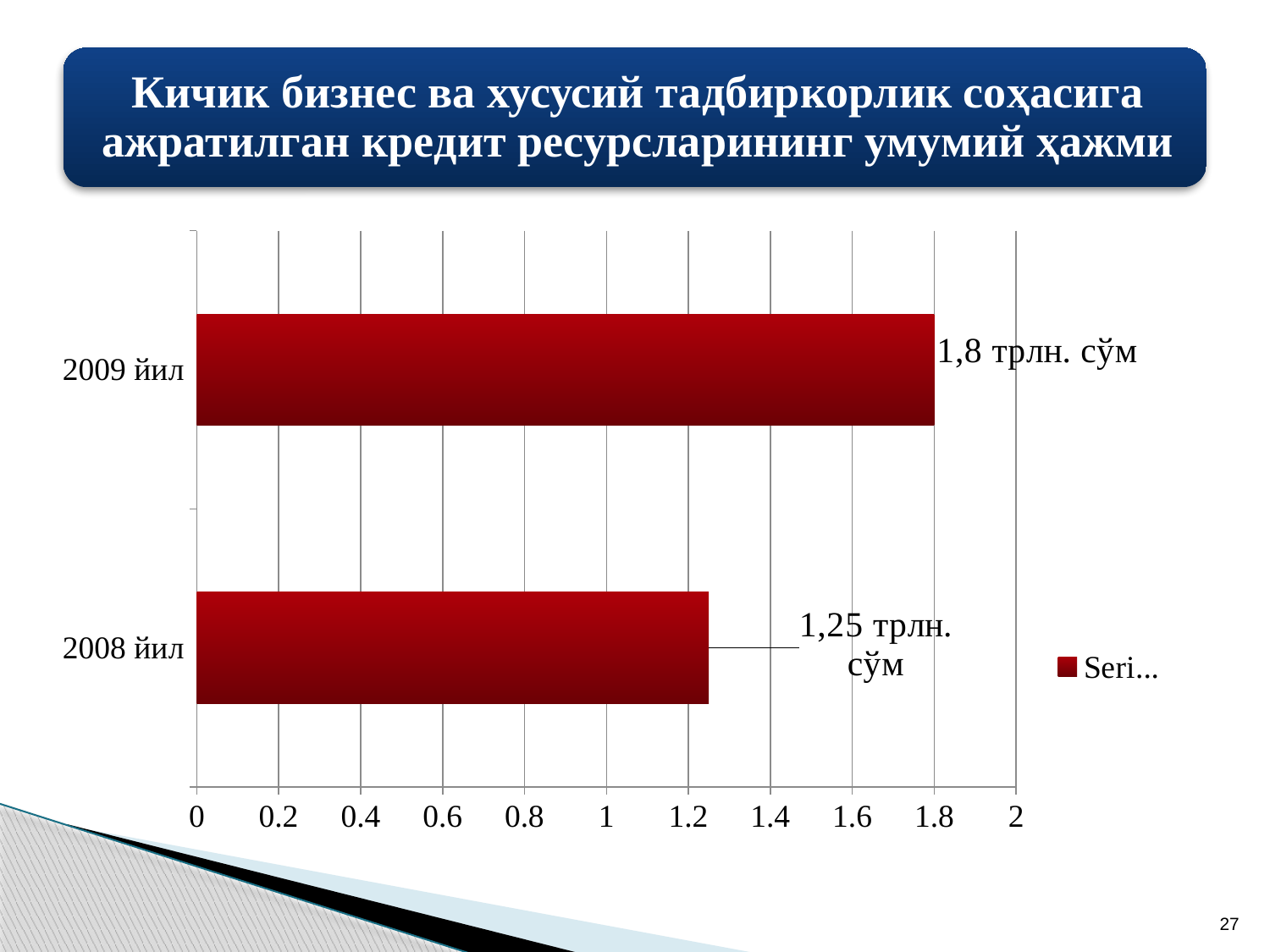
Is the value for 2008 йил greater or less than 1.4? less What is the value for 2009 йил? 1,8 трлн. сўм Which year has the lowest value? 2008 йил What is the maximum value shown on the horizontal axis? 2 Is the value for 2009 йил greater or less than 1.6? greater How many categories are shown in the chart? 2 What is the value for 2008 йил? 1,25 трлн. сўм Which is larger, the value for 2009 йил or the value for 2008 йил? 2009 йил What is the difference between the values for 2009 йил and 2008 йил? 0,55 трлн. сўм Which year has the highest value? 2009 йил How many series does the legend list? 1 What kind of chart is shown on the slide? bar chart